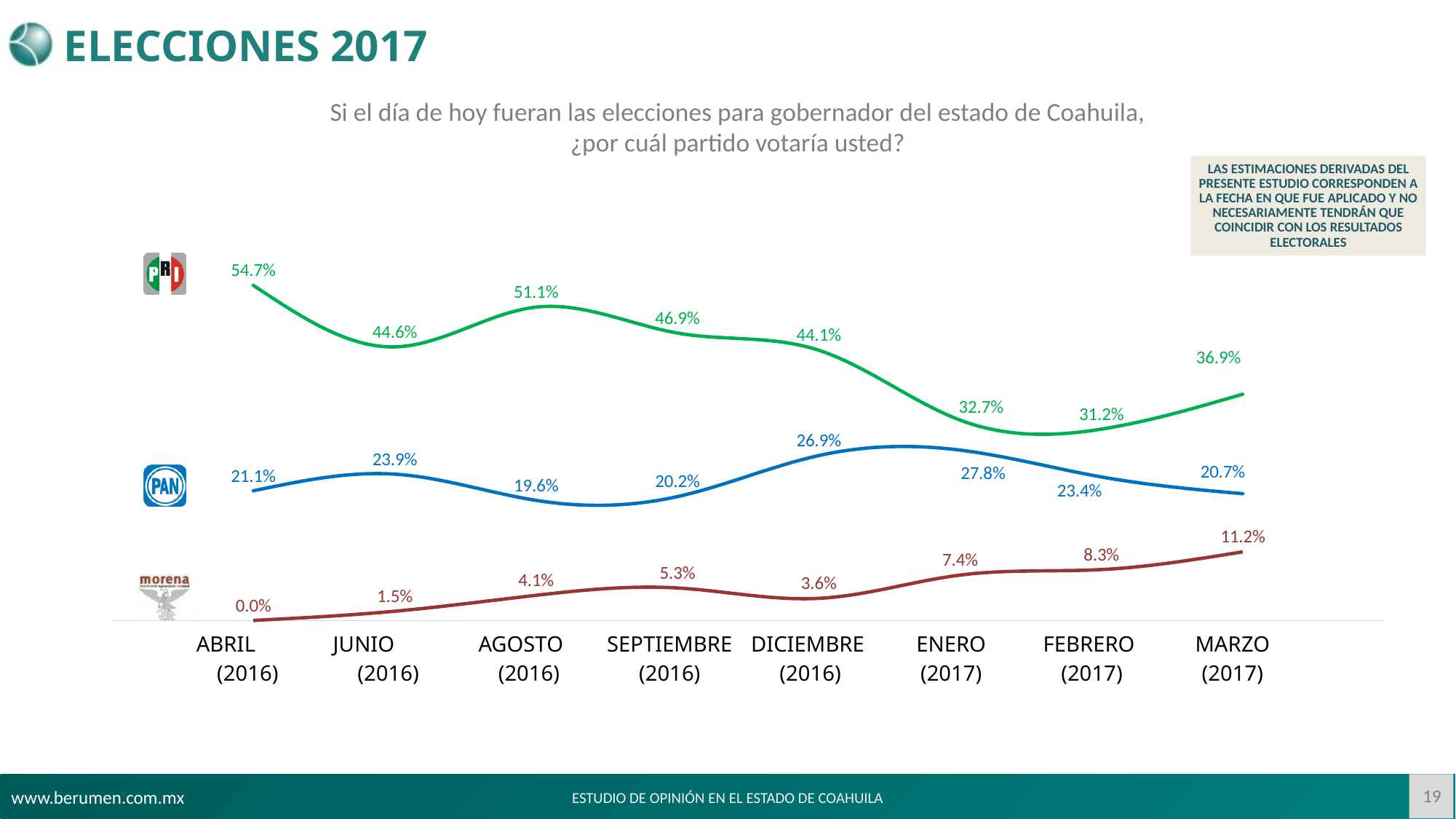
In which survey period does the PRI line reach its highest value? Abril (2016) What value is shown for PAN in Diciembre (2016)? 26.9% What type of chart is used on this slide? Line chart What percentage of respondents said they would vote for PRI in Abril (2016)? 54.7% Does the Morena line generally rise or fall from Abril (2016) to Marzo (2017)? Rise In which survey period does the PRI line reach its lowest value? Febrero (2017) What value is shown for Morena in Marzo (2017)? 11.2% How many survey periods are shown on the x axis? 8 In Marzo (2017), which party has the higher value, PAN or Morena? PAN In which survey period does PAN reach its highest value? Enero (2017) By how many percentage points did PRI's value fall from Abril (2016) to Marzo (2017)? 17.8 percentage points How many parties (lines) are plotted on the chart? 3